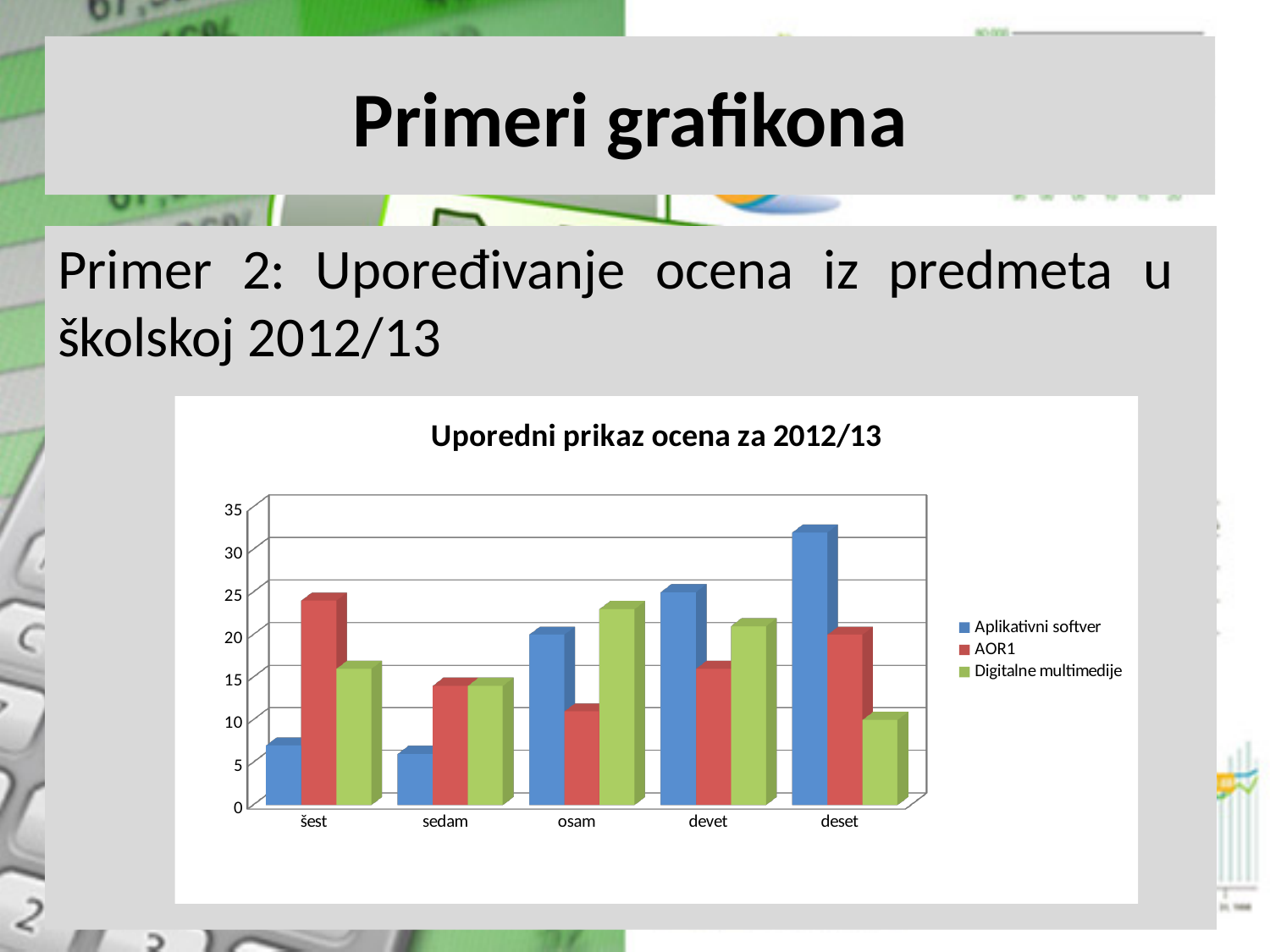
For which category is the AOR1 value highest? šest Which colour represents the AOR1 series in the chart? red Is the Digitalne multimedije value for deset greater or less than 15? less For which category is the Aplikativni softver value highest? deset What is the title of the chart? Uporedni prikaz ocena za 2012/13 Is the Aplikativni softver value for deset greater or less than 30? greater How many categories are shown on the x axis of the chart? 5 How many series does the chart's legend list? 3 For the category deset, which is larger: Aplikativni softver or Digitalne multimedije? Aplikativni softver For which category is the AOR1 value lowest? osam For the category osam, which is larger: AOR1 or Digitalne multimedije? Digitalne multimedije What kind of chart is shown on the slide? bar chart